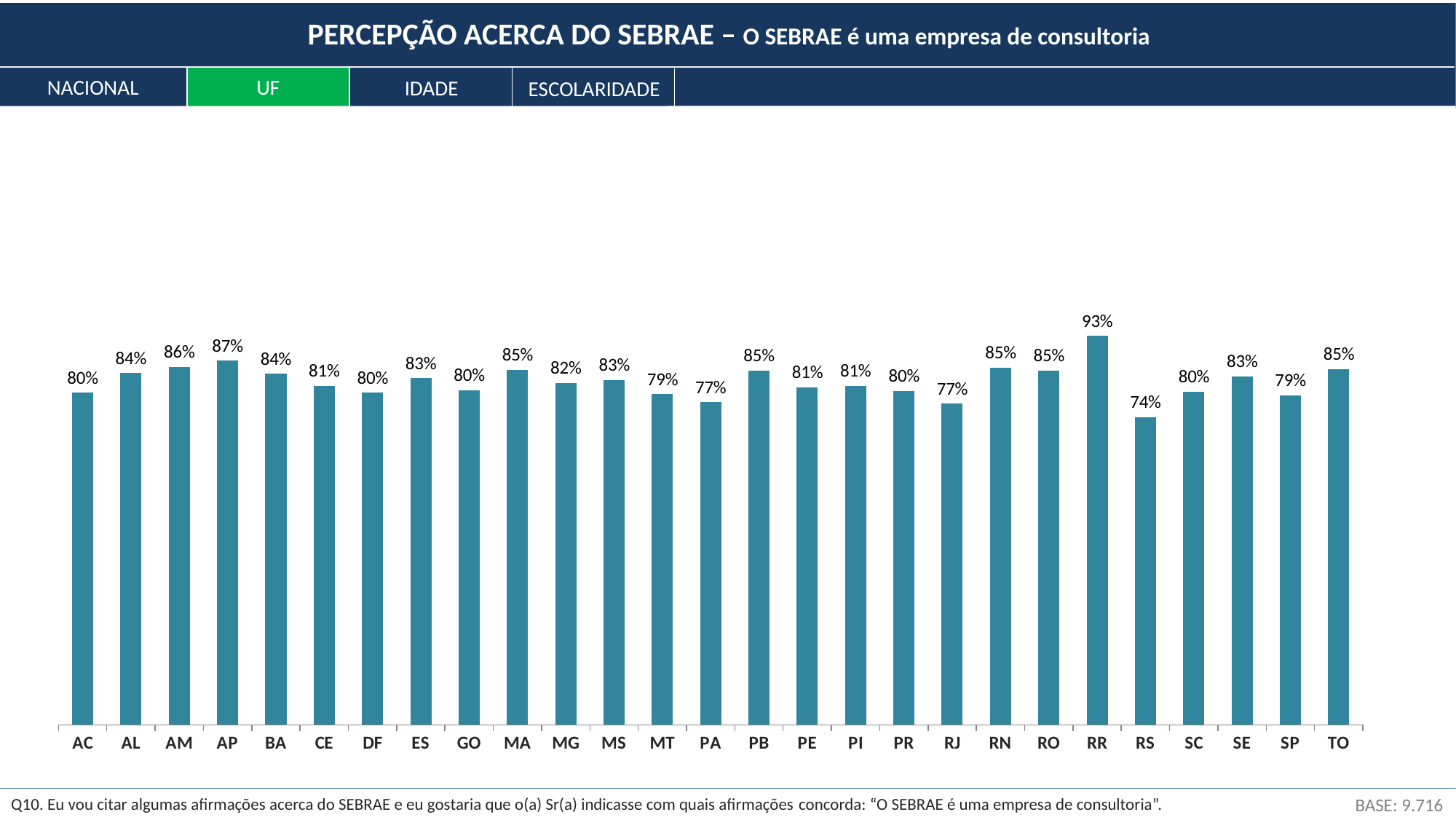
What is the value for AP? 87% What is the difference between the values for RR and RS? 19% Which is larger, the value for AM or the value for MT? AM What is the value for RS? 74% How many states (UF) are shown on the x axis? 27 Which state has the highest value? RR What is the difference between the values for AP and PA? 10% Which state has the lowest value? RS Which tab is highlighted in green at the top of the slide? UF What is the value for MG? 82% What kind of chart is shown on the slide? Bar chart What is the value for RR? 93%